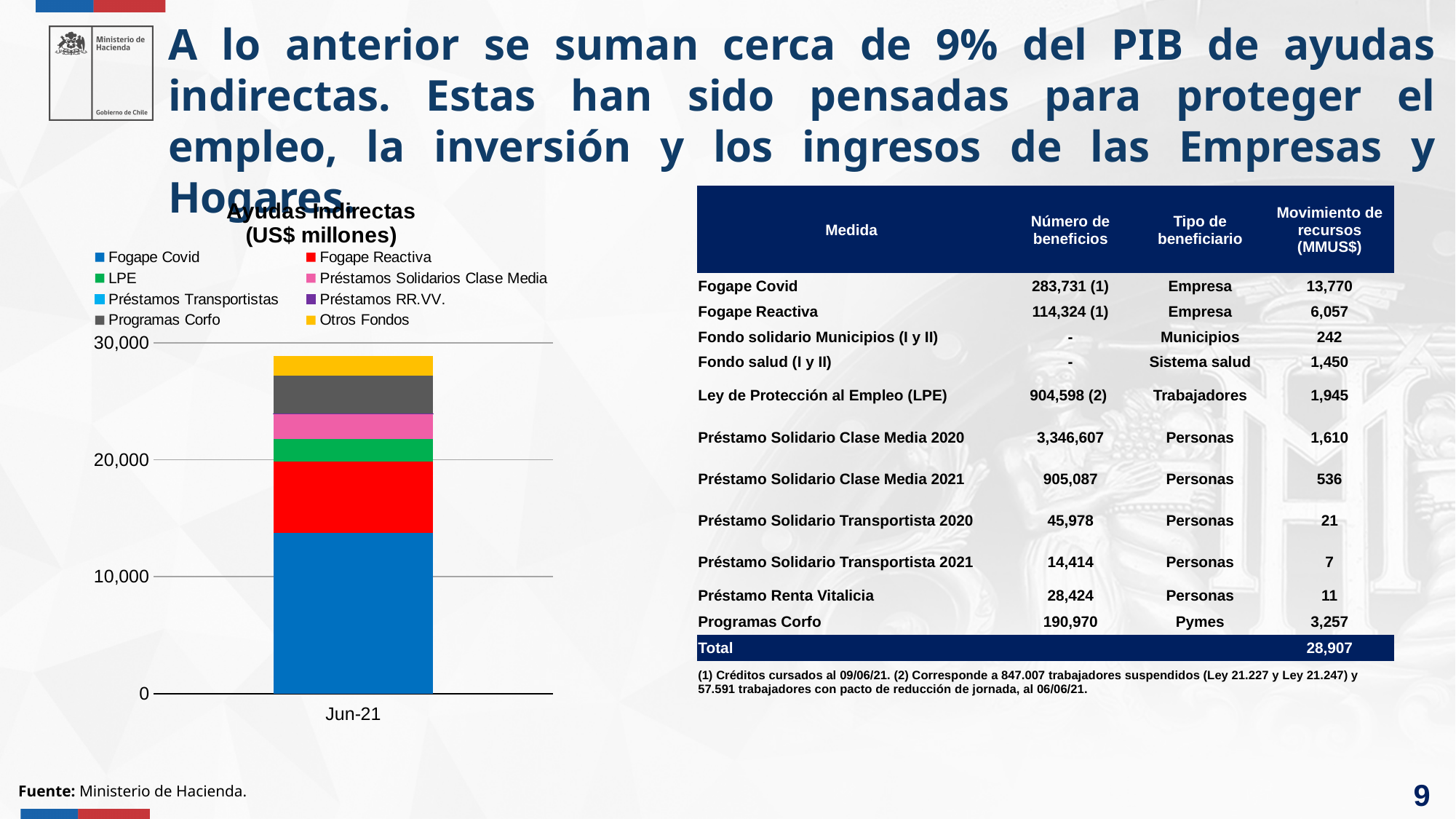
Which series forms the largest segment of the stacked bar for Jun-21? Fogape Covid Is the total height of the Jun-21 stacked bar greater or less than 30,000? less Is the Fogape Covid segment of the Jun-21 bar greater or less than 20,000? less Is the Fogape Covid segment of the Jun-21 bar greater or less than 10,000? greater What is the category label on the x axis of the 'Ayudas Indirectas' chart? Jun-21 Which segment is larger in the Jun-21 bar, Programas Corfo or Otros Fondos? Programas Corfo How many series does the legend of the 'Ayudas Indirectas' chart list? 8 Which segment is larger in the Jun-21 bar, Fogape Covid or Fogape Reactiva? Fogape Covid What kind of chart is shown on the slide? Stacked bar chart How many categories are plotted on the x axis of the 'Ayudas Indirectas' chart? 1 What is the title of the chart on the slide? Ayudas Indirectas (US$ millones)